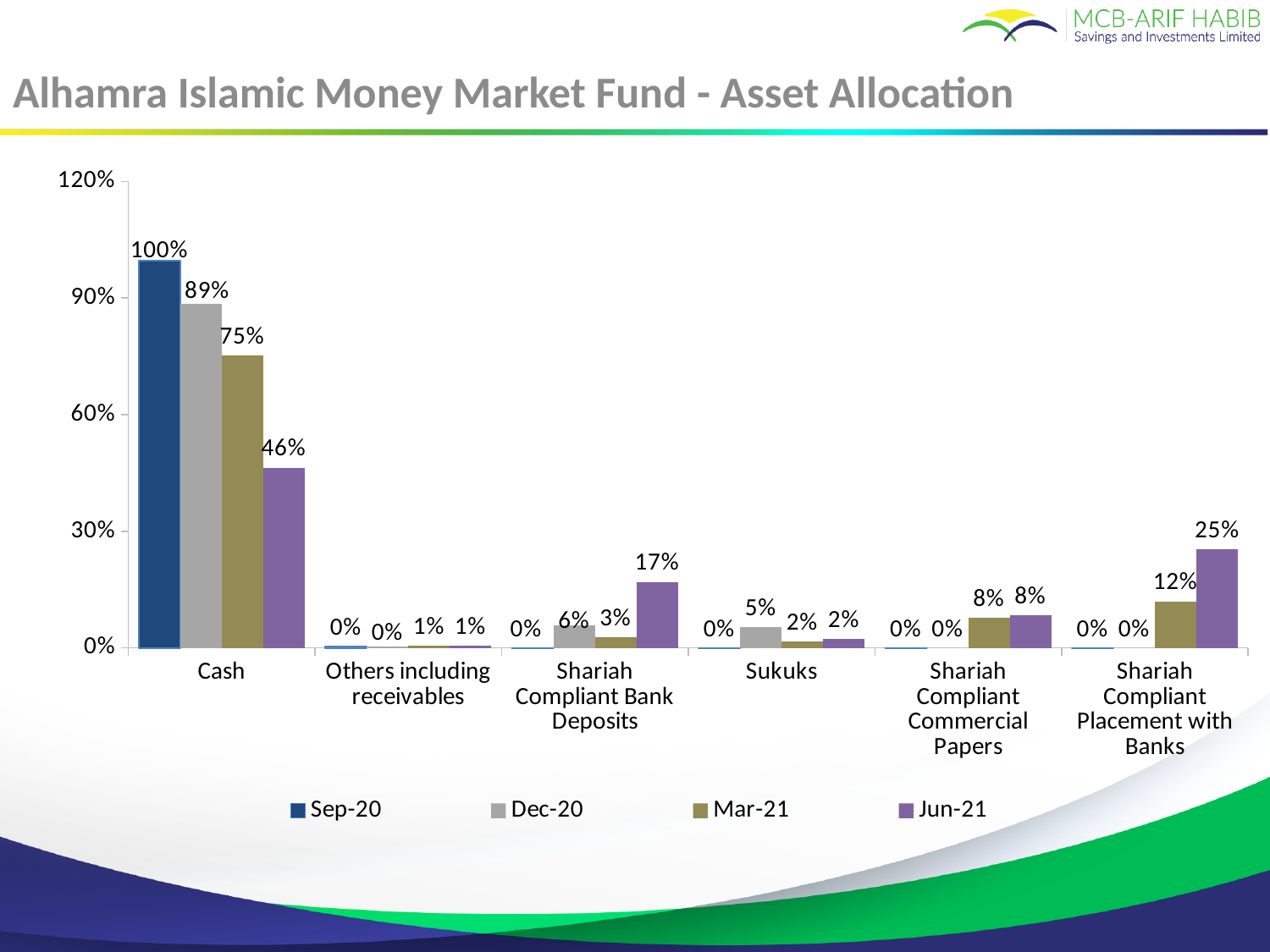
How many categories are shown on the x axis? 6 Which is larger for Shariah Compliant Placement with Banks: the Mar-21 value or the Jun-21 value? Jun-21 What is the difference between the Sep-20 and Dec-20 values for Cash? 11% What kind of chart is shown on the slide? Bar chart What is the Jun-21 value for Shariah Compliant Placement with Banks? 25% What is the Cash allocation for Jun-21? 46% What is the Cash allocation for Sep-20? 100% How many series does the legend list? 4 Which category has the highest Jun-21 value? Cash What is the Dec-20 value for Sukuks? 5% Does the Cash allocation rise or fall from Sep-20 to Jun-21? Fall What is the Jun-21 value for Shariah Compliant Bank Deposits? 17%